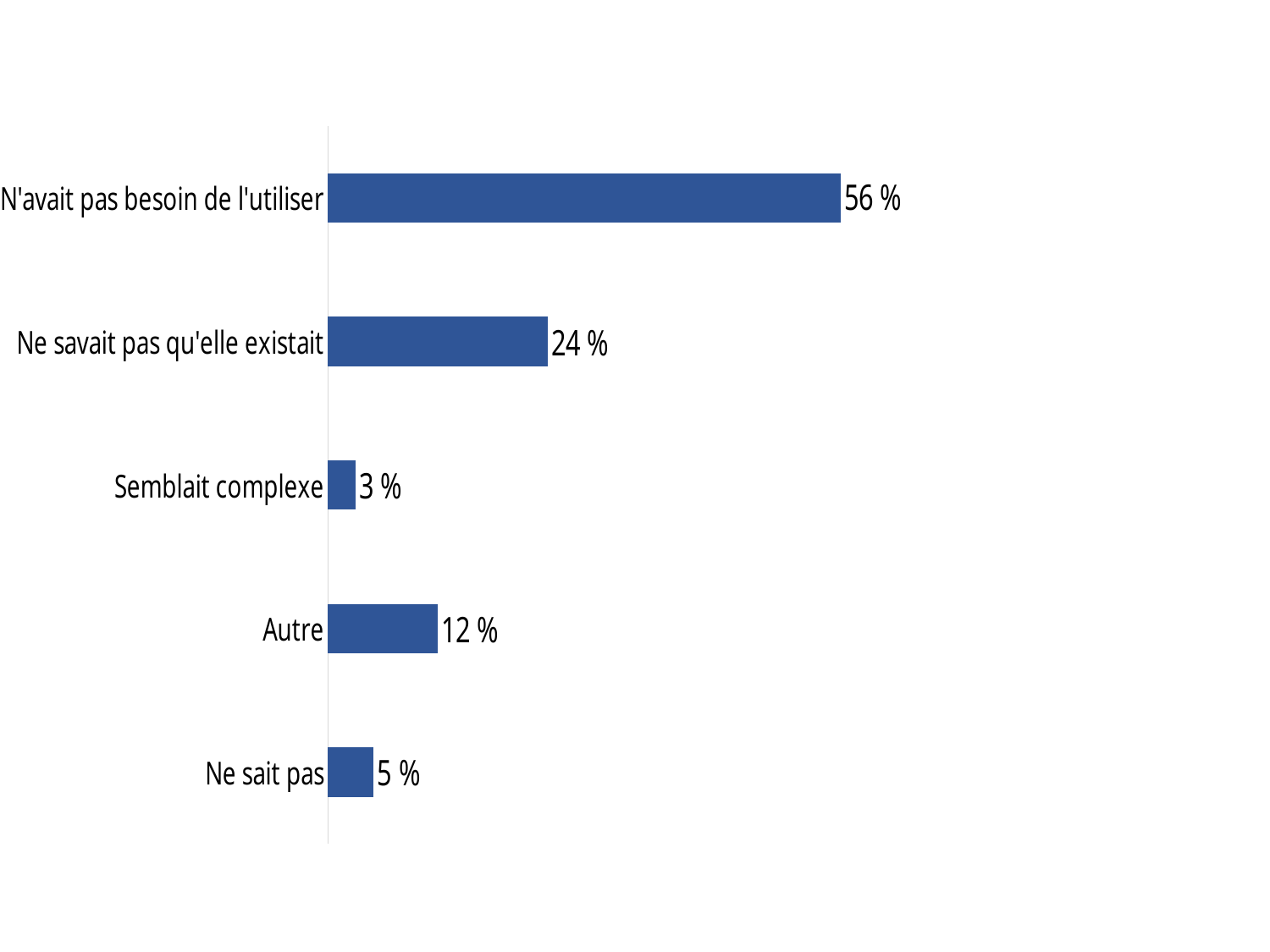
Which category has the highest value? N'avait pas besoin de l'utiliser What is the difference between the values for "N'avait pas besoin de l'utiliser" and "Ne savait pas qu'elle existait"? 32 % Which category has the lowest value? Semblait complexe What is the value for "Ne sait pas"? 5 % What kind of chart is shown on the slide? Bar chart What is the value for "Ne savait pas qu'elle existait"? 24 % What is the value for "Semblait complexe"? 3 % What is the difference between the values for "Autre" and "Semblait complexe"? 9 % What is the value for "Autre"? 12 % Which is larger, the value for "Autre" or the value for "Ne sait pas"? Autre What is the value for "N'avait pas besoin de l'utiliser"? 56 % How many categories are shown in the chart? 5